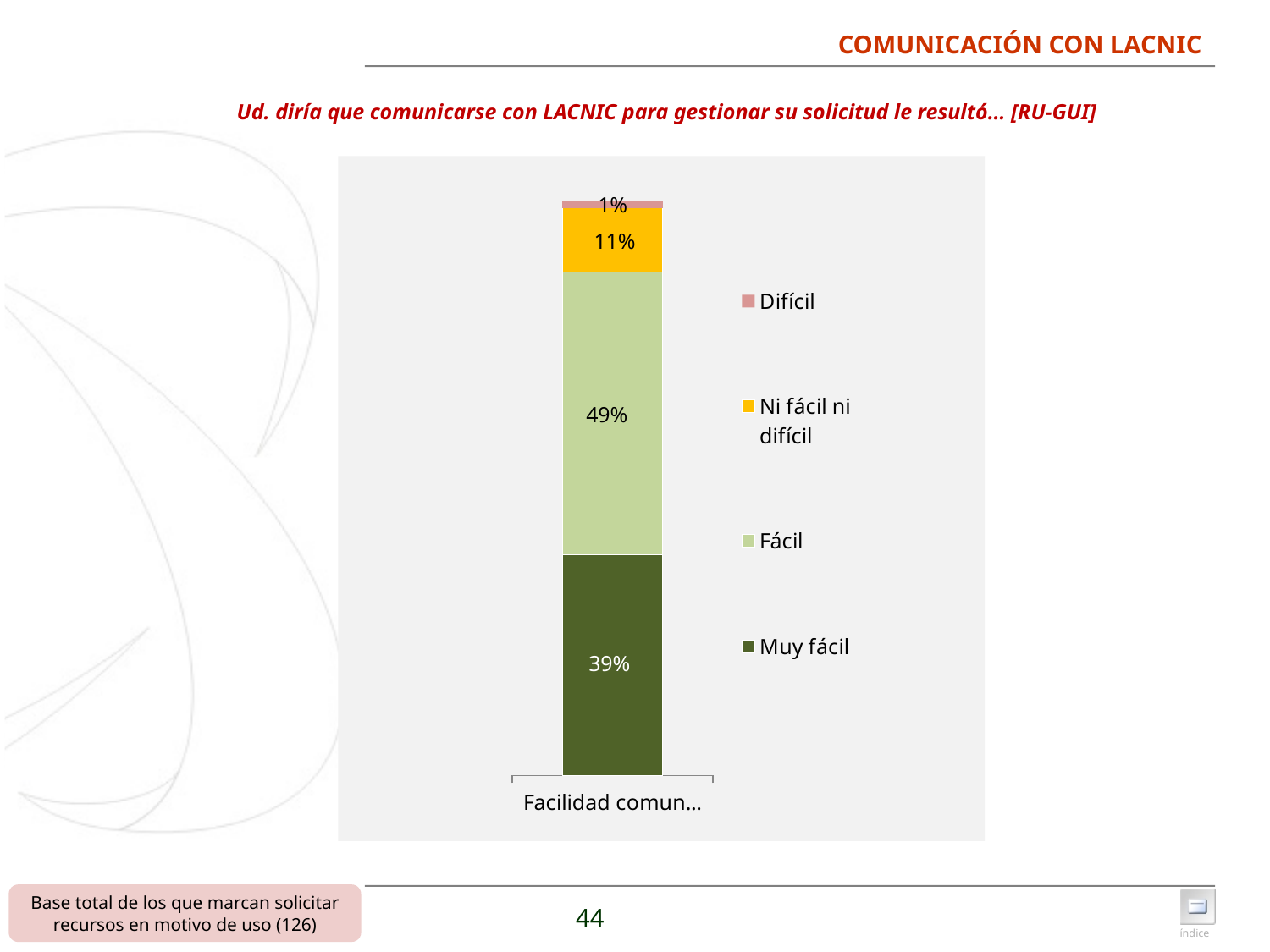
Which response has the largest share in the stacked bar? Fácil What percentage of respondents answered "Difícil"? 1% What percentage of respondents answered "Muy fácil"? 39% Which response has the smallest share in the stacked bar? Difícil Which is larger, the share for "Ni fácil ni difícil" or the share for "Difícil"? Ni fácil ni difícil What is the difference in percentage points between "Fácil" and "Muy fácil"? 10 What is the combined percentage of "Muy fácil" and "Fácil" responses? 88% What colour represents "Ni fácil ni difícil" in the chart? Yellow How many series does the legend list? 4 What kind of chart is shown on the slide? Stacked bar chart What percentage of respondents answered "Ni fácil ni difícil"? 11% What percentage of respondents answered "Fácil"? 49%